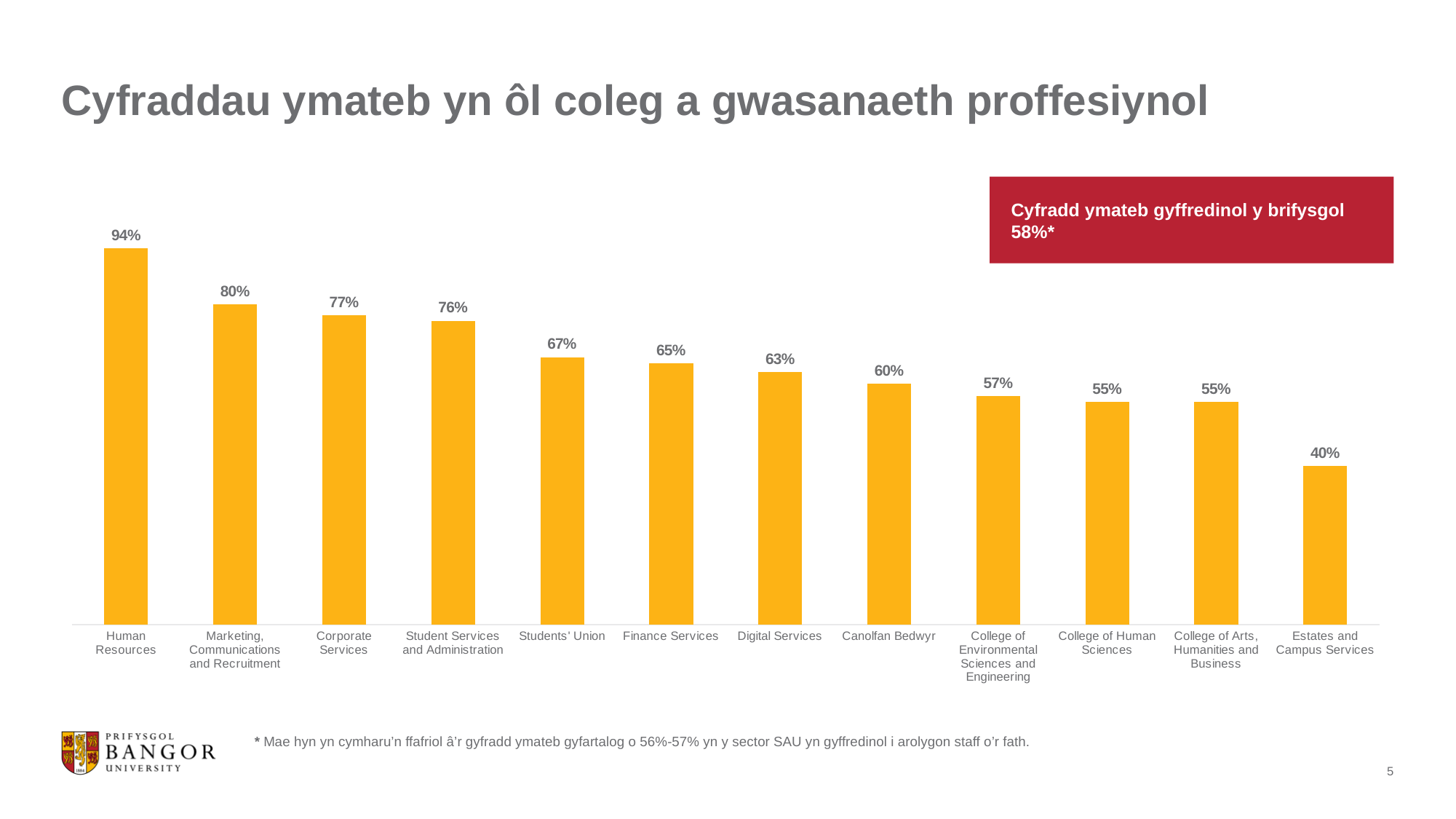
What is the response rate for Estates and Campus Services? 40% Which category has the lowest response rate? Estates and Campus Services What is the response rate for Human Resources? 94% What is the response rate for Canolfan Bedwyr? 60% How many categories are shown in the chart? 12 What is the difference between the response rates for Human Resources and Estates and Campus Services? 54% What kind of chart is shown on the slide? Bar chart Do the values rise or fall from left to right across the chart? Fall What overall university response rate is stated in the red box on the slide? 58% What is the difference between the response rates for Marketing, Communications and Recruitment and Corporate Services? 3% Which has a higher response rate, Students' Union or Digital Services? Students' Union Which category has the highest response rate? Human Resources